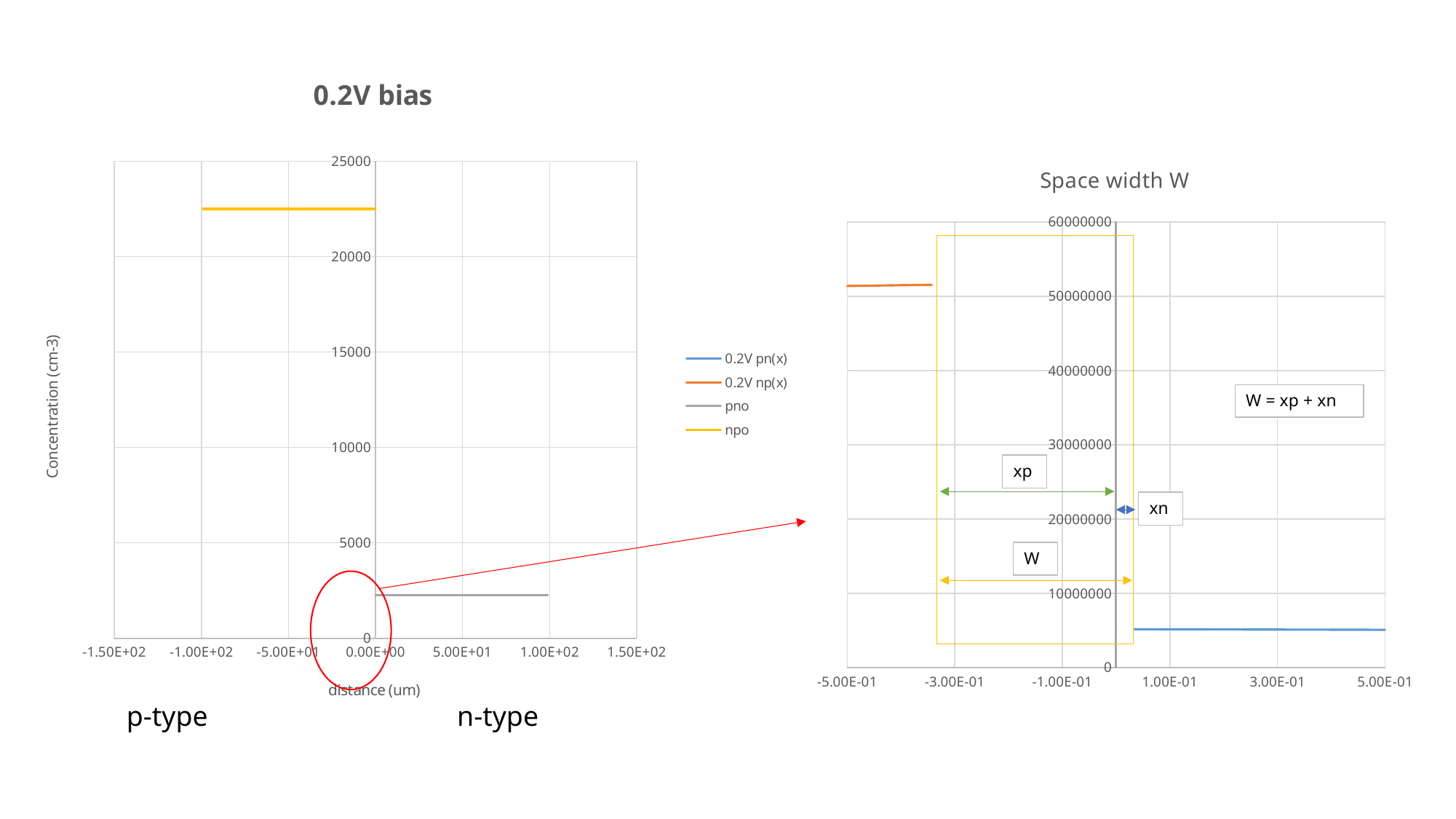
In the '0.2V bias' chart, which line is higher, npo or pno? npo What is the x-axis label of the '0.2V bias' chart? distance (um) How many series does the legend of the '0.2V bias' chart list? 4 In the 'Space width W' chart, which line is higher, the orange line or the blue line? the orange line What is the title of the chart on the right side of the slide? Space width W In the 'Space width W' chart, is the value of the orange line on the left side greater or less than 50000000? greater In the '0.2V bias' chart, is the value of the pno line greater or less than 5000? less In the 'Space width W' chart, is the value of the blue line on the right side greater or less than 10000000? less What is the y-axis label of the '0.2V bias' chart? Concentration (cm-3) What kind of chart is the '0.2V bias' chart? line chart